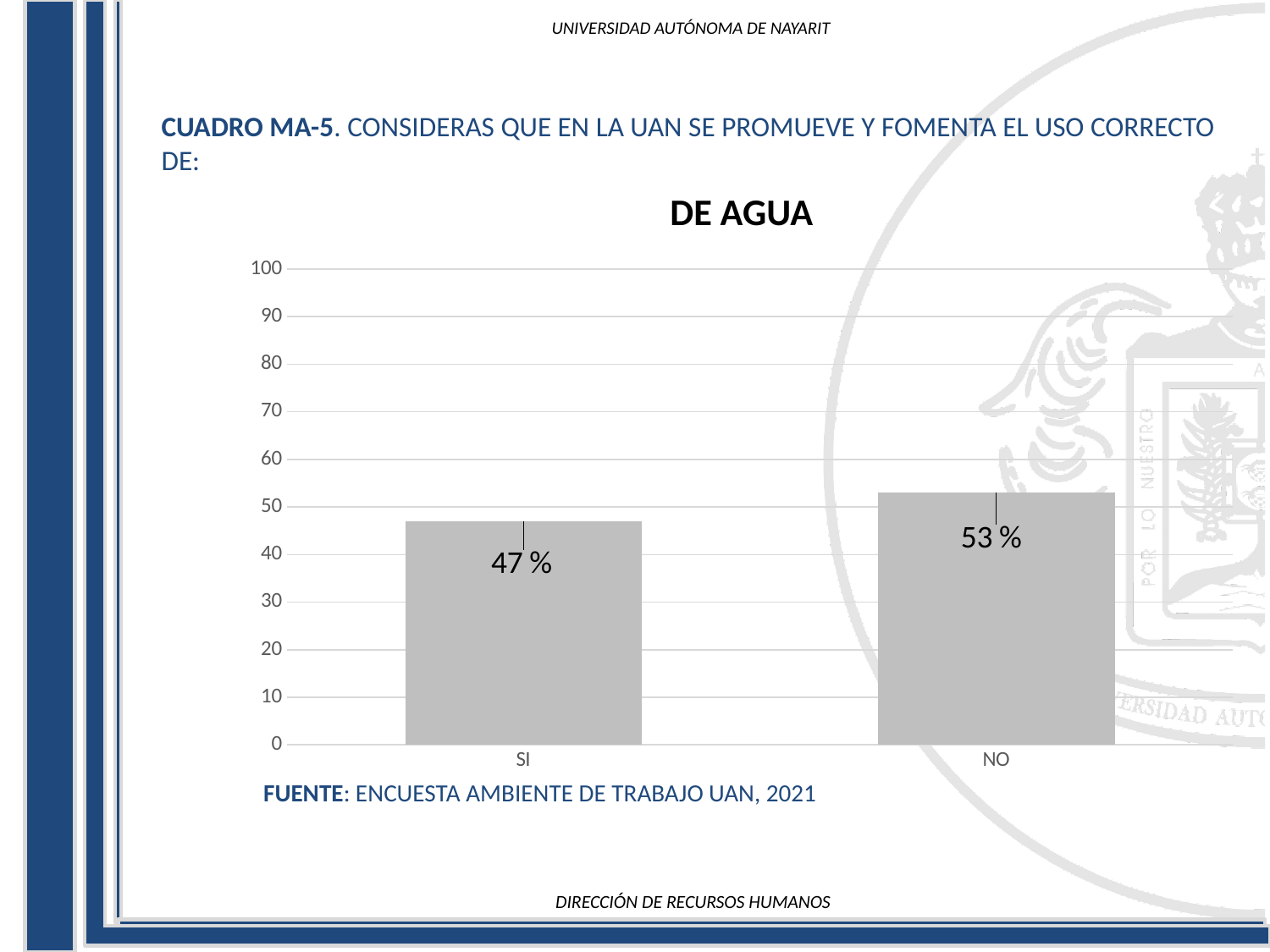
What is the highest value shown on the y axis? 100 What is the title of the chart? DE AGUA Which category has the lowest value? SI What is the value for SI? 47 % Is the value for NO greater or less than 50? greater Which is larger, the value for SI or the value for NO? NO Is the value for SI greater or less than 50? less How many categories are shown on the x axis? 2 What is the difference between the values for NO and SI? 6 % What is the value for NO? 53 % Which category has the highest value? NO What kind of chart is shown on the slide? bar chart